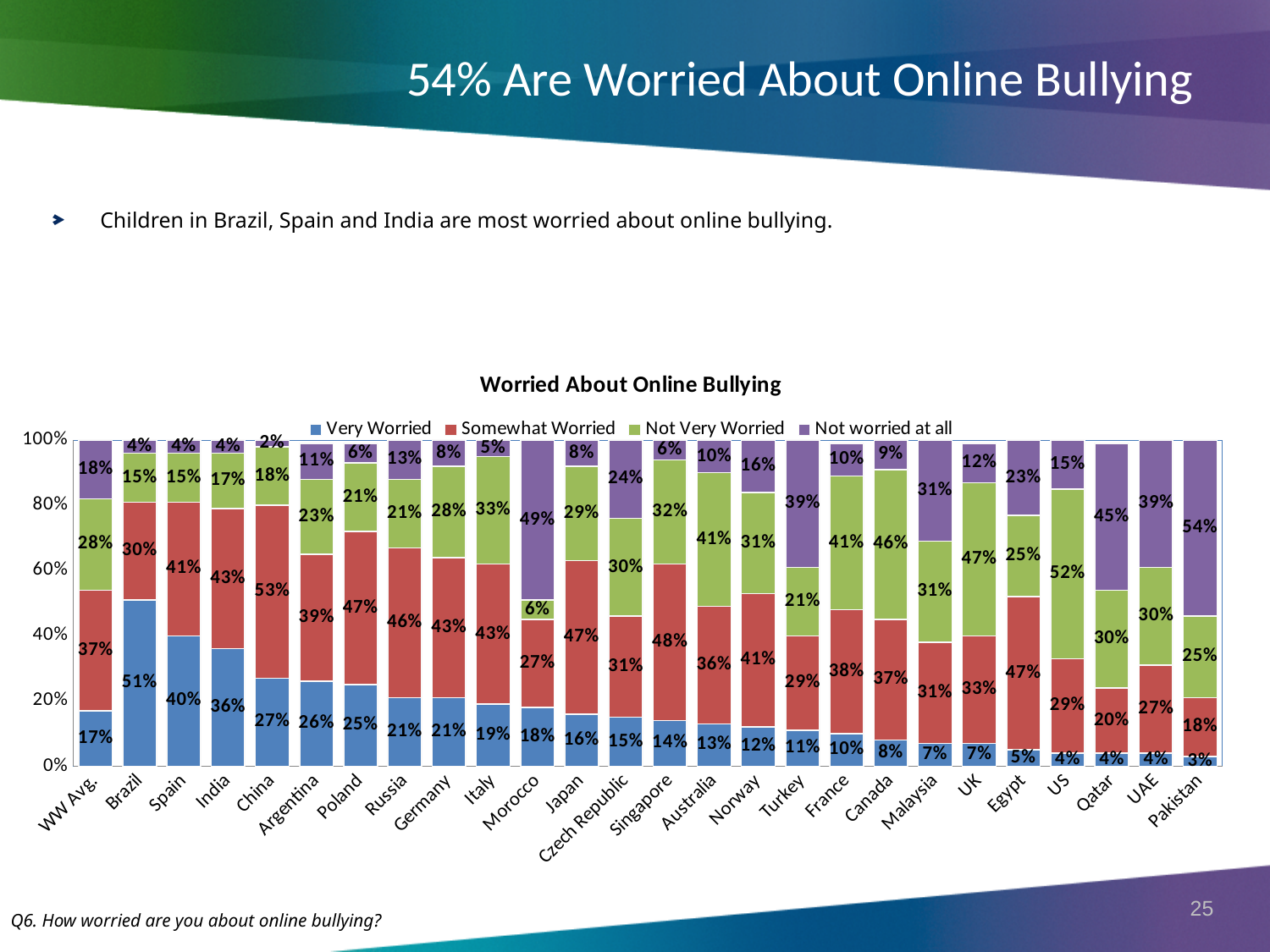
What is the total of the four segments in the Brazil bar? 100% Which country has the highest Very Worried percentage? Brazil What is the Not worried at all value for Pakistan? 54% How many series does the legend list? 4 What percentage of children in Brazil are Very Worried about online bullying? 51% How many countries or categories are shown on the x axis, including WW Avg? 26 Which country has the lowest Very Worried percentage? Pakistan What is the Somewhat Worried value for China? 53% Which has a larger Not worried at all value, Morocco or Qatar? Morocco What kind of chart is shown on the slide? Stacked bar chart What is the Not Very Worried value for the US? 52% What is the difference between the Very Worried values for Brazil and Spain? 11%